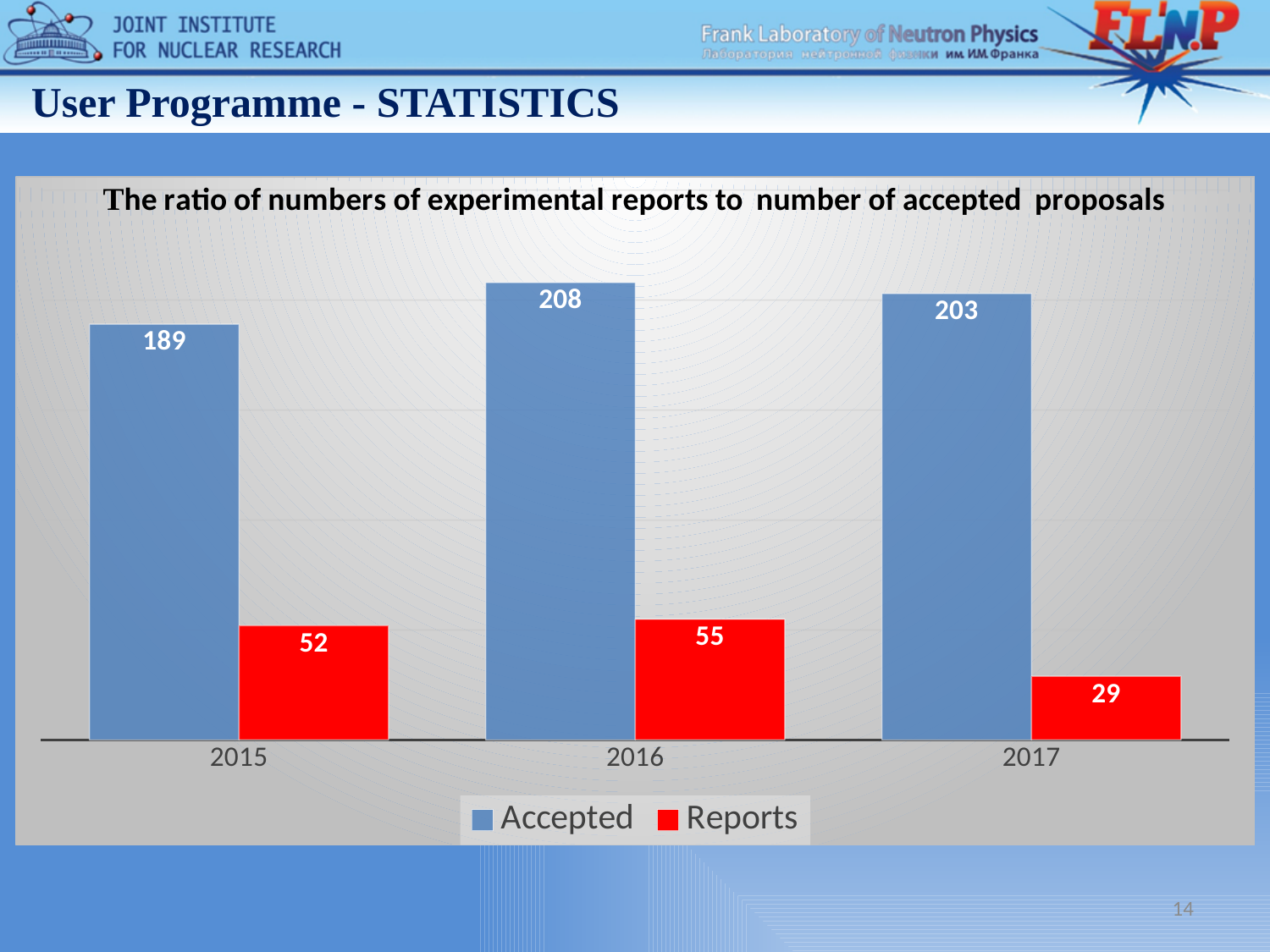
What colour are the Reports bars? red What is the difference between the Reports values for 2016 and 2017? 26 Which year has the lowest Reports value? 2017 Which year has the highest Accepted value? 2016 How many years are shown on the x axis? 3 What is the difference between the Accepted and Reports values for 2015? 137 What kind of chart is shown on the slide? bar chart What is the Accepted value for 2015? 189 Which is larger, the Accepted value for 2017 or the Accepted value for 2015? 2017 What is the Reports value for 2017? 29 What is the Accepted value for 2016? 208 How many series does the legend list? 2